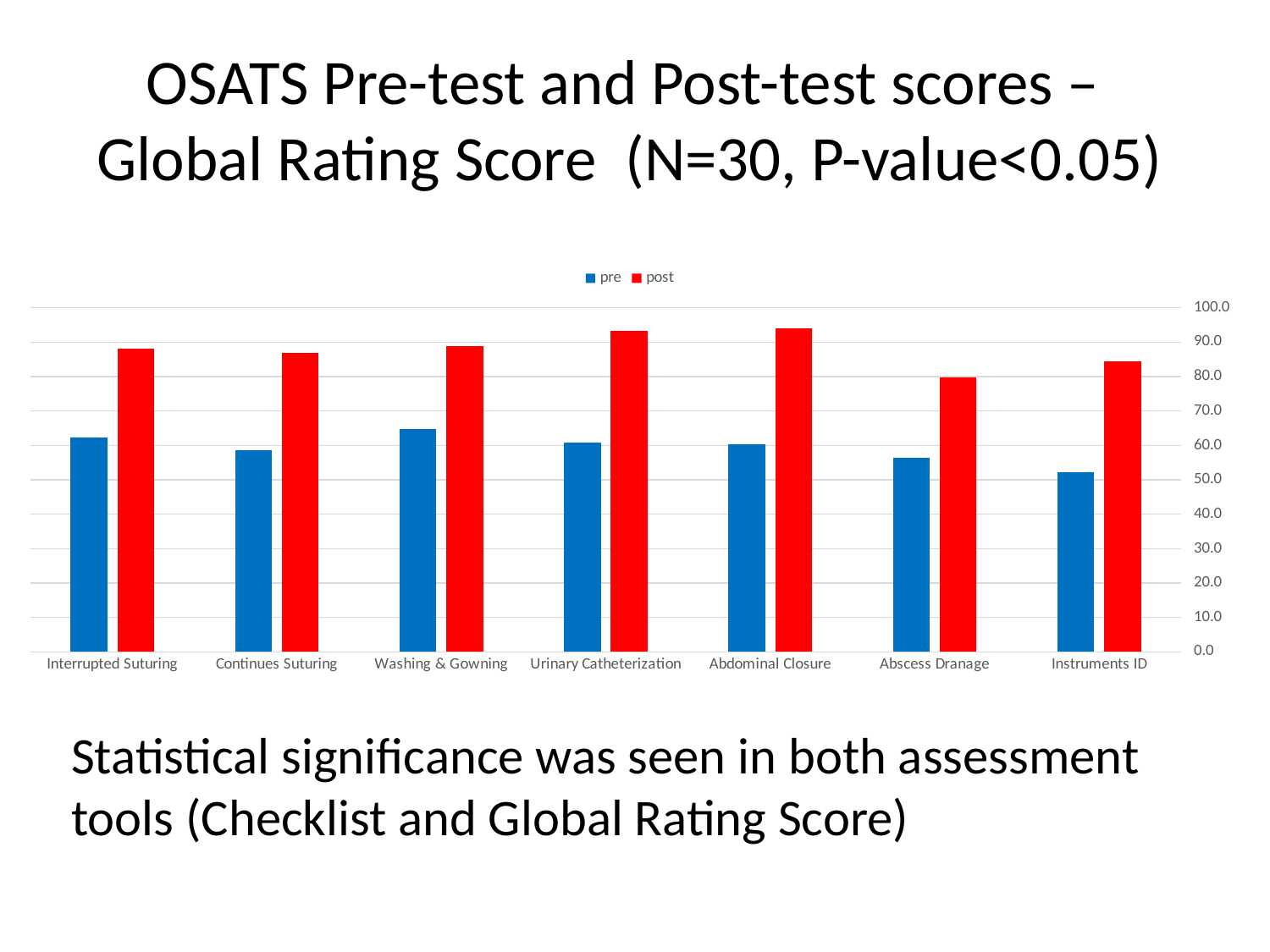
Which category has the lowest post score? Abscess Dranage Which is larger, the post score for Interrupted Suturing or the post score for Instruments ID? Interrupted Suturing For Abdominal Closure, which is larger, the pre score or the post score? post Is the pre value for Washing & Gowning greater or less than 60.0? greater Is the post value for Urinary Catheterization greater or less than 90.0? greater What colour are the bars for the post series? red How many series does the legend list? 2 Is the post value for Instruments ID greater or less than 80.0? greater How many categories are shown on the x axis? 7 What kind of chart is shown on the slide? bar chart Which category has the lowest pre score? Instruments ID